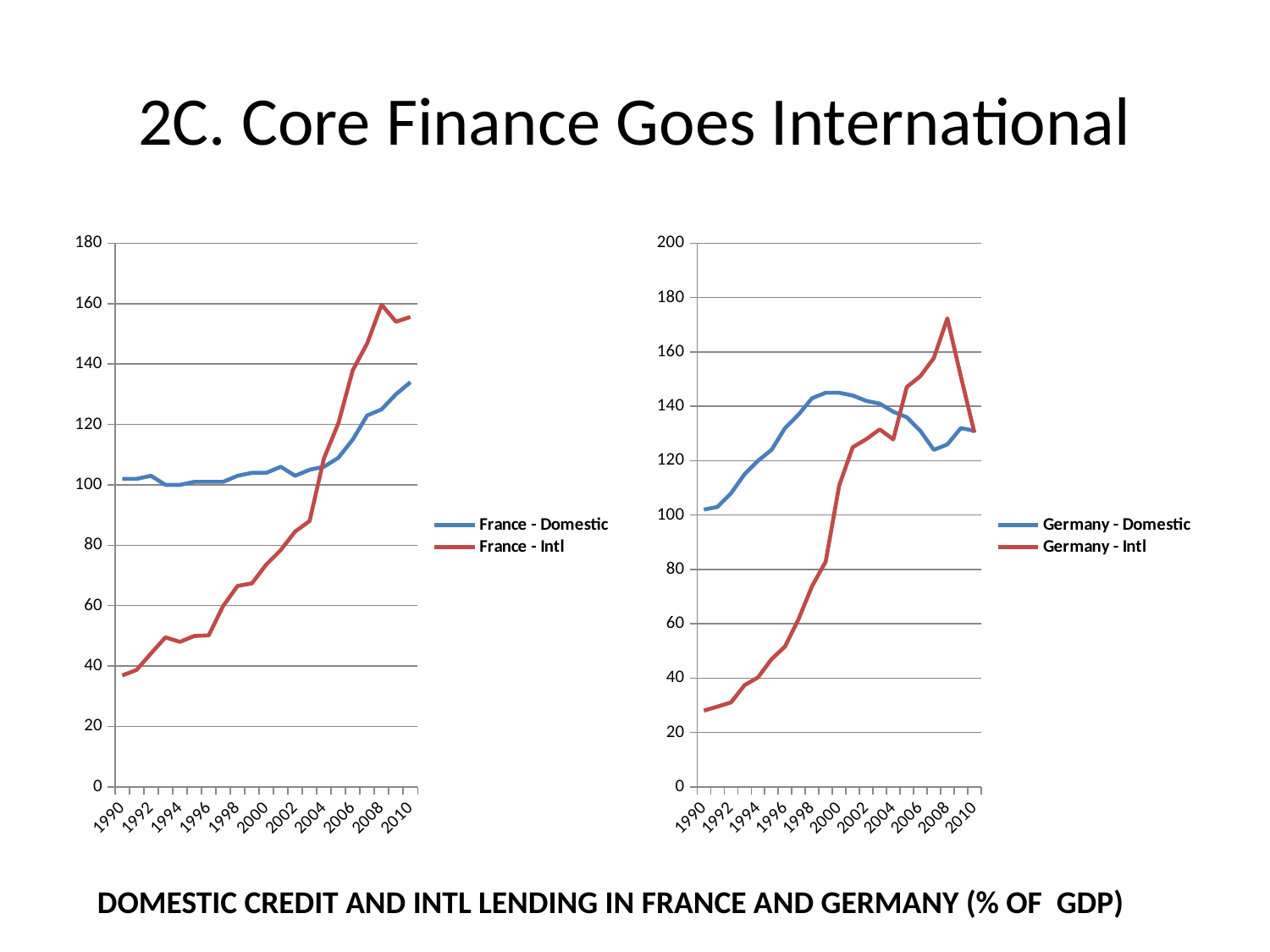
In the right chart (Germany), which series has the higher value in 1990, Germany - Domestic or Germany - Intl? Germany - Domestic What kind of chart is the left chart (France)? line chart In the left chart (France), is the value for France - Intl in 2008 greater or less than 140? greater In the right chart (Germany), is the value for Germany - Domestic in 2008 greater or less than 140? less In the right chart (Germany), is the value for Germany - Intl in 2008 greater or less than 160? greater How many series does the legend of the right chart (Germany) list? 2 In the left chart (France), which two series are listed in the legend? France - Domestic and France - Intl In the left chart (France), which series has the higher value in 2010, France - Domestic or France - Intl? France - Intl In the left chart (France), does the France - Intl series generally rise or fall from 1990 to 2010? rise